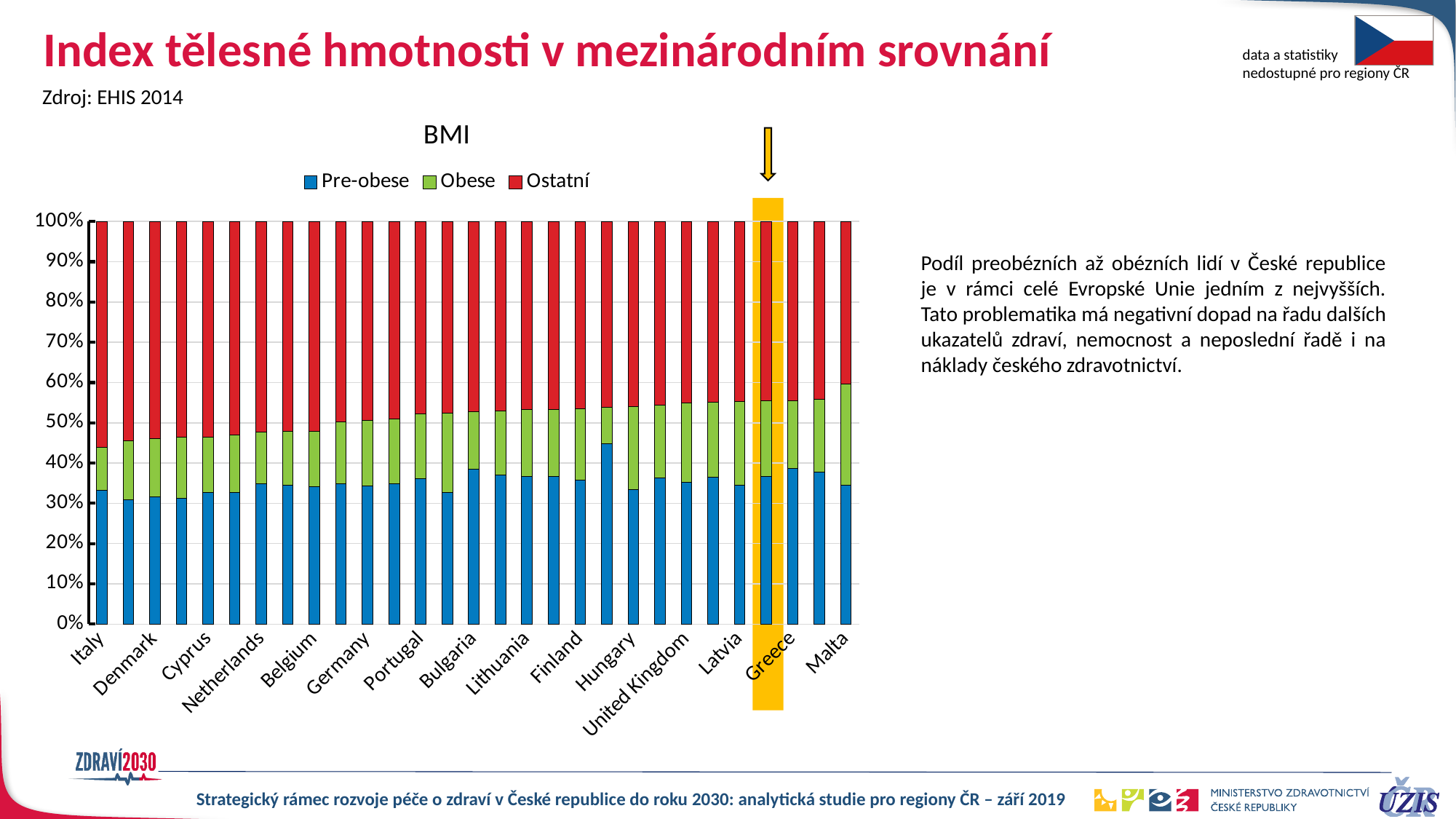
What are the three series named in the legend of the BMI chart? Pre-obese, Obese, Ostatní Is the Pre-obese value for Hungary greater or less than 40%? less What kind of chart is shown on the slide? Stacked bar chart Among the labelled countries, which has the largest Ostatní share? Italy Is the Pre-obese value for Italy greater or less than 30%? greater Is the combined Pre-obese and Obese share for Malta greater or less than 50%? greater Does the combined Pre-obese and Obese share rise or fall from left to right across the countries? Rise How many series does the legend of the BMI chart list? 3 Which colour represents the Ostatní series in the BMI chart? Red